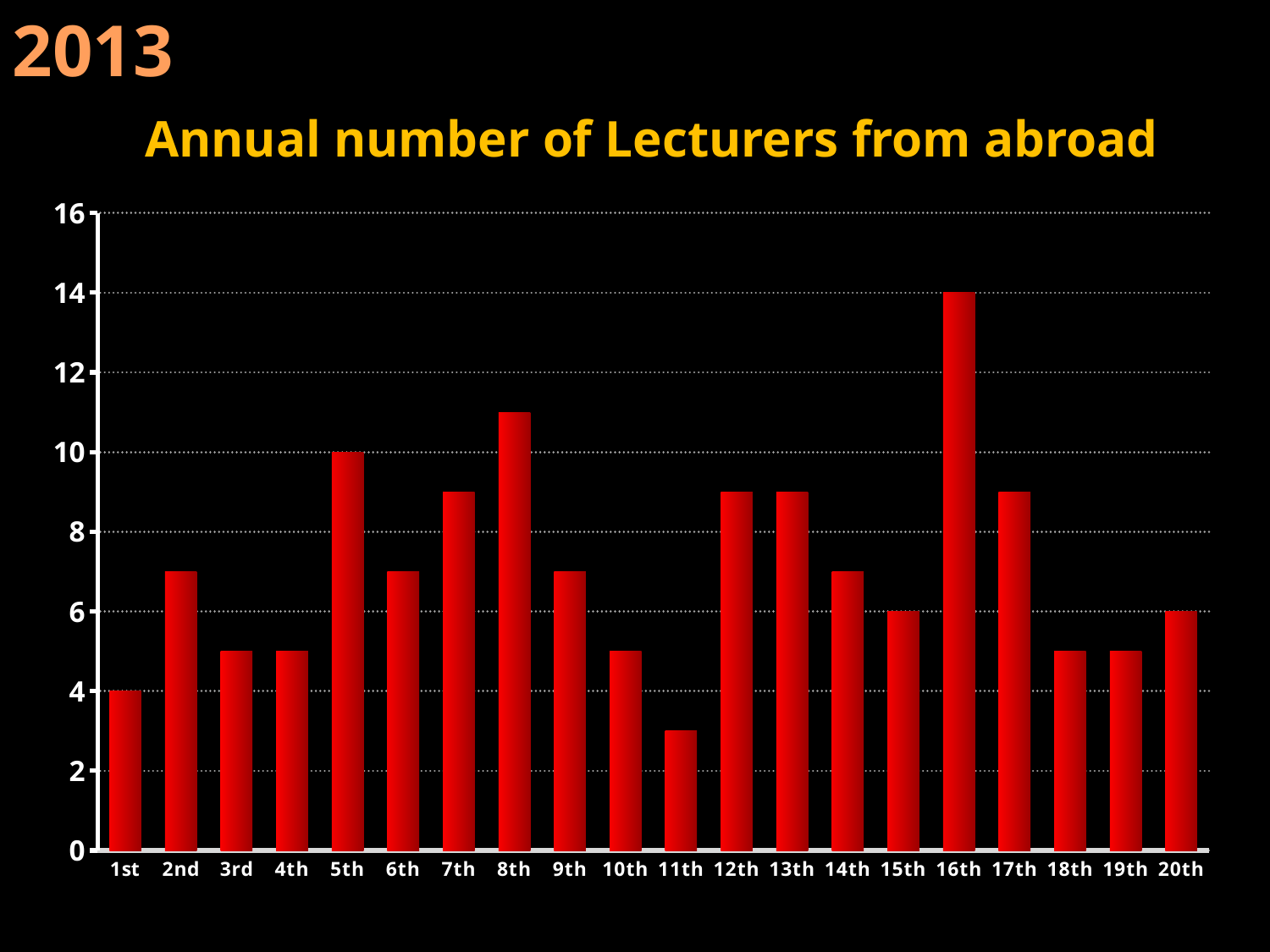
Is the value for the 8th category greater or less than 10? greater Which category has the highest value? 16th What is the value for the 5th category? 10 Which category has the lowest value? 11th What type of chart is shown on the slide? bar chart What is the difference between the values for the 16th and 5th categories? 4 How many categories are shown on the x axis? 20 What is the value for the 20th category? 6 What is the value for the 16th category? 14 What is the value for the 1st category? 4 What is the title of the chart? Annual number of Lecturers from abroad Which is larger, the value for the 16th category or the 8th category? 16th